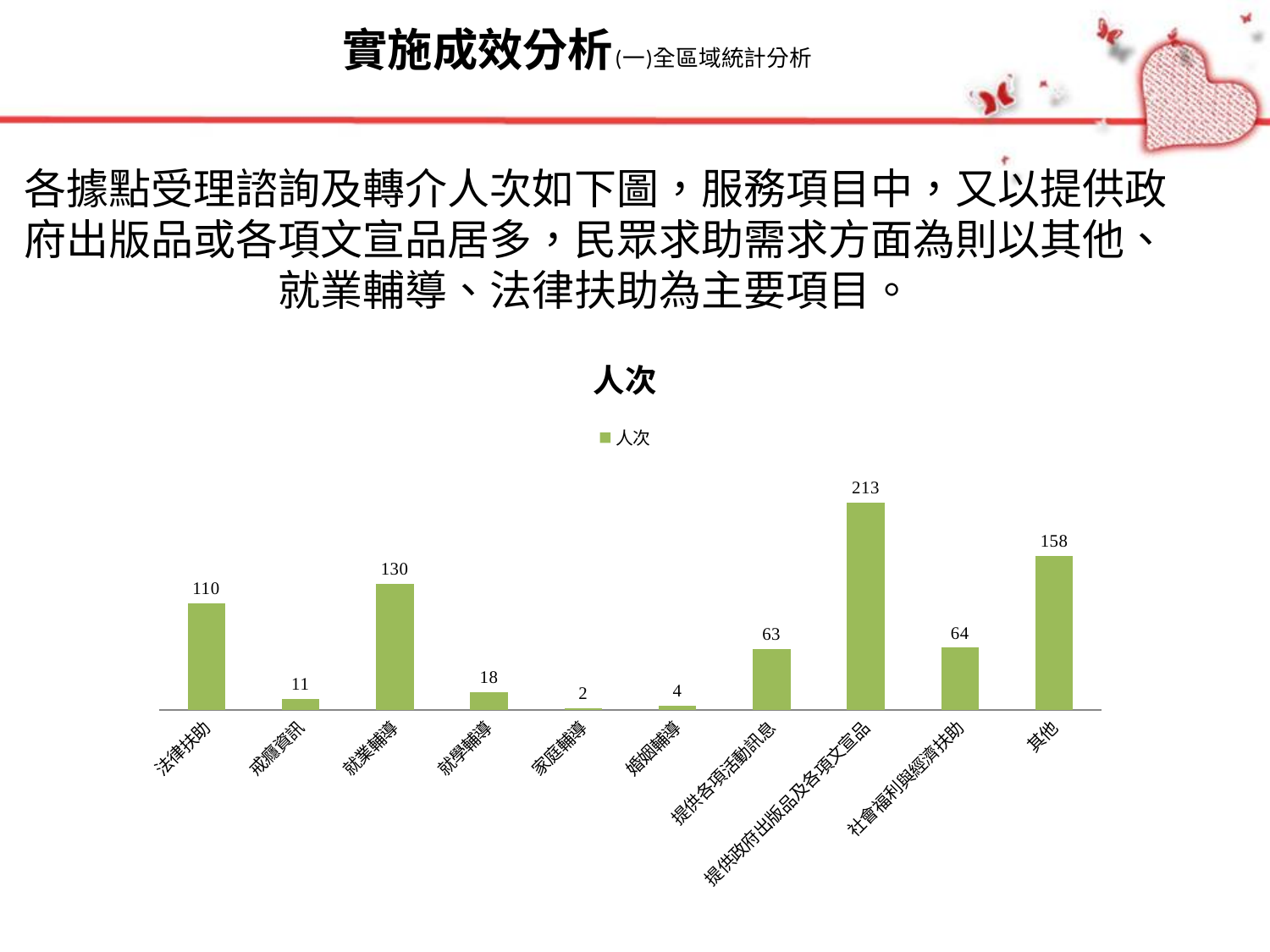
Which category has the lowest value? 家庭輔導 What is the value for 法律扶助 in the 人次 chart? 110 What kind of chart is shown on the slide? bar chart How many categories are shown in the chart? 10 What is the value for 提供政府出版品及各項文宣品? 213 What is the title of the chart? 人次 Which category has the highest value? 提供政府出版品及各項文宣品 What is the value for 家庭輔導? 2 How many series does the legend list? 1 What is the difference between the values for 就業輔導 and 法律扶助? 20 What is the value for 其他? 158 Which is larger, the value for 提供各項活動訊息 or 社會福利與經濟扶助? 社會福利與經濟扶助